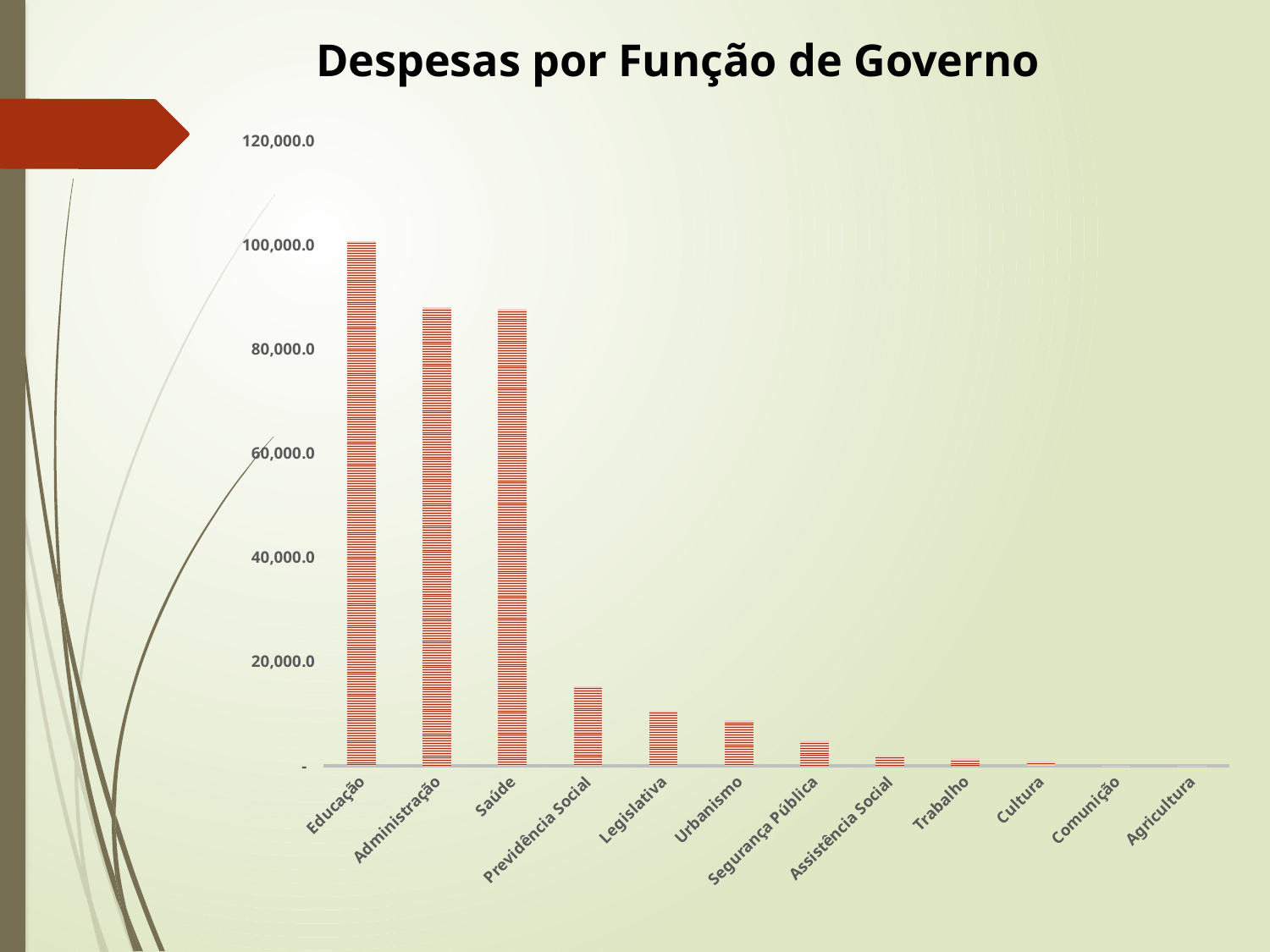
How many categories are shown on the x axis of the chart? 12 Is the value for Previdência Social greater or less than 20,000.0? less Which is larger, the value for Previdência Social or the value for Legislativa? Previdência Social Do the values generally rise or fall moving from left to right along the x axis? fall Is the value for Administração greater or less than 100,000.0? less Is the value for Saúde greater or less than 80,000.0? greater Which is larger, the value for Educação or the value for Administração? Educação Which category has the highest value in the chart? Educação What kind of chart is shown on the slide? bar chart What is the title of the chart? Despesas por Função de Governo